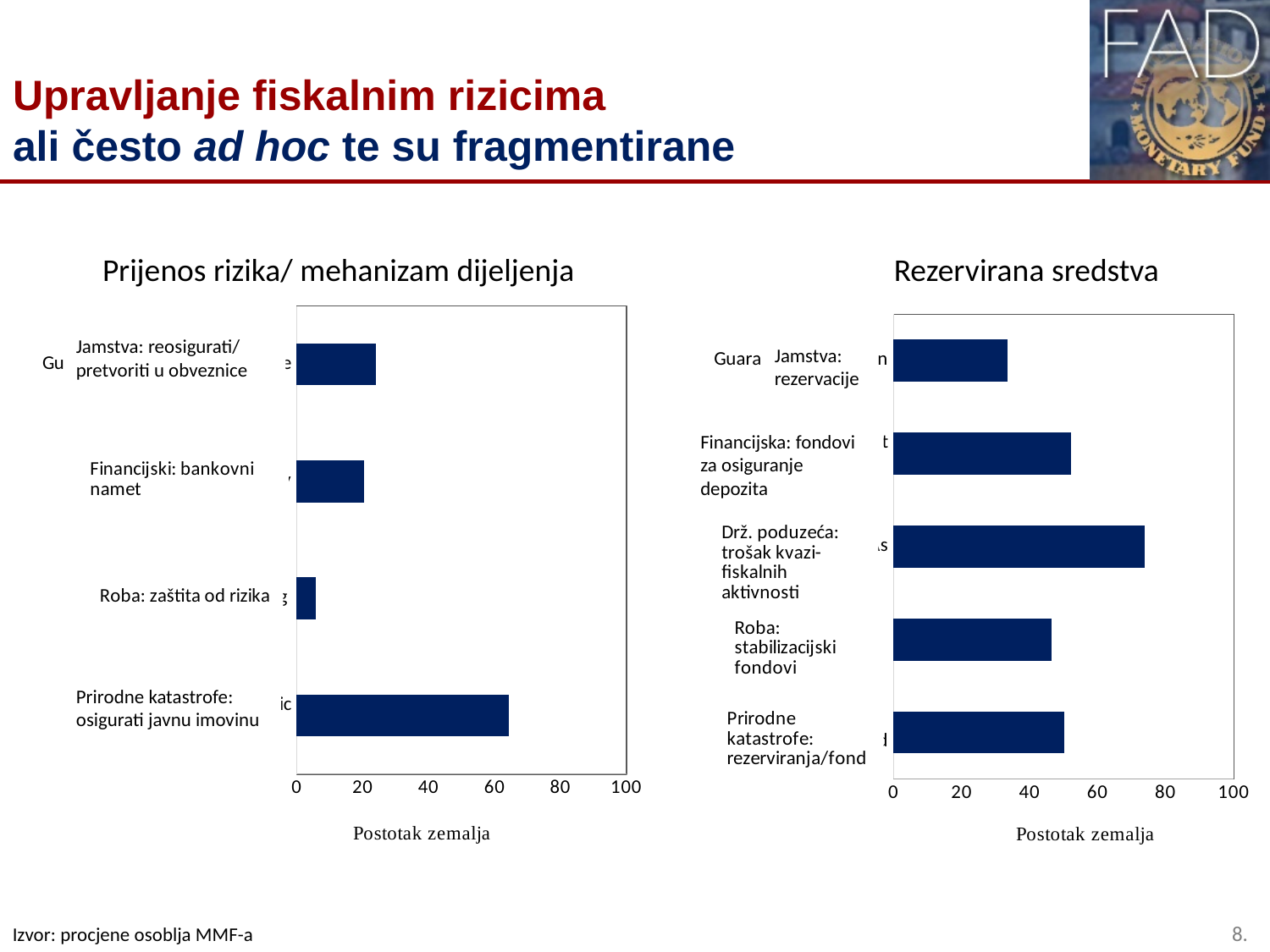
How many categories are shown in the 'Prijenos rizika/ mehanizam dijeljenja' chart? 4 What is the x-axis label of the 'Rezervirana sredstva' chart? Postotak zemalja In the 'Prijenos rizika/ mehanizam dijeljenja' chart, which category has the highest value? Prirodne katastrofe: osigurati javnu imovinu In the 'Prijenos rizika/ mehanizam dijeljenja' chart, is the value for 'Roba: zaštita od rizika' greater or less than 20? less In the 'Rezervirana sredstva' chart, which category has the lowest value? Jamstva: rezervacije In the 'Rezervirana sredstva' chart, which is larger: 'Financijska: fondovi za osiguranje depozita' or 'Jamstva: rezervacije'? Financijska: fondovi za osiguranje depozita What kind of chart is the 'Prijenos rizika/ mehanizam dijeljenja' chart? bar chart In the 'Rezervirana sredstva' chart, is the value for 'Drž. poduzeća: trošak kvazi-fiskalnih aktivnosti' greater or less than 60? greater In the 'Prijenos rizika/ mehanizam dijeljenja' chart, is the value for 'Prirodne katastrofe: osigurati javnu imovinu' greater or less than 60? greater In the 'Rezervirana sredstva' chart, which category has the highest value? Drž. poduzeća: trošak kvazi-fiskalnih aktivnosti In the 'Prijenos rizika/ mehanizam dijeljenja' chart, which category has the lowest value? Roba: zaštita od rizika How many categories are shown in the 'Rezervirana sredstva' chart? 5